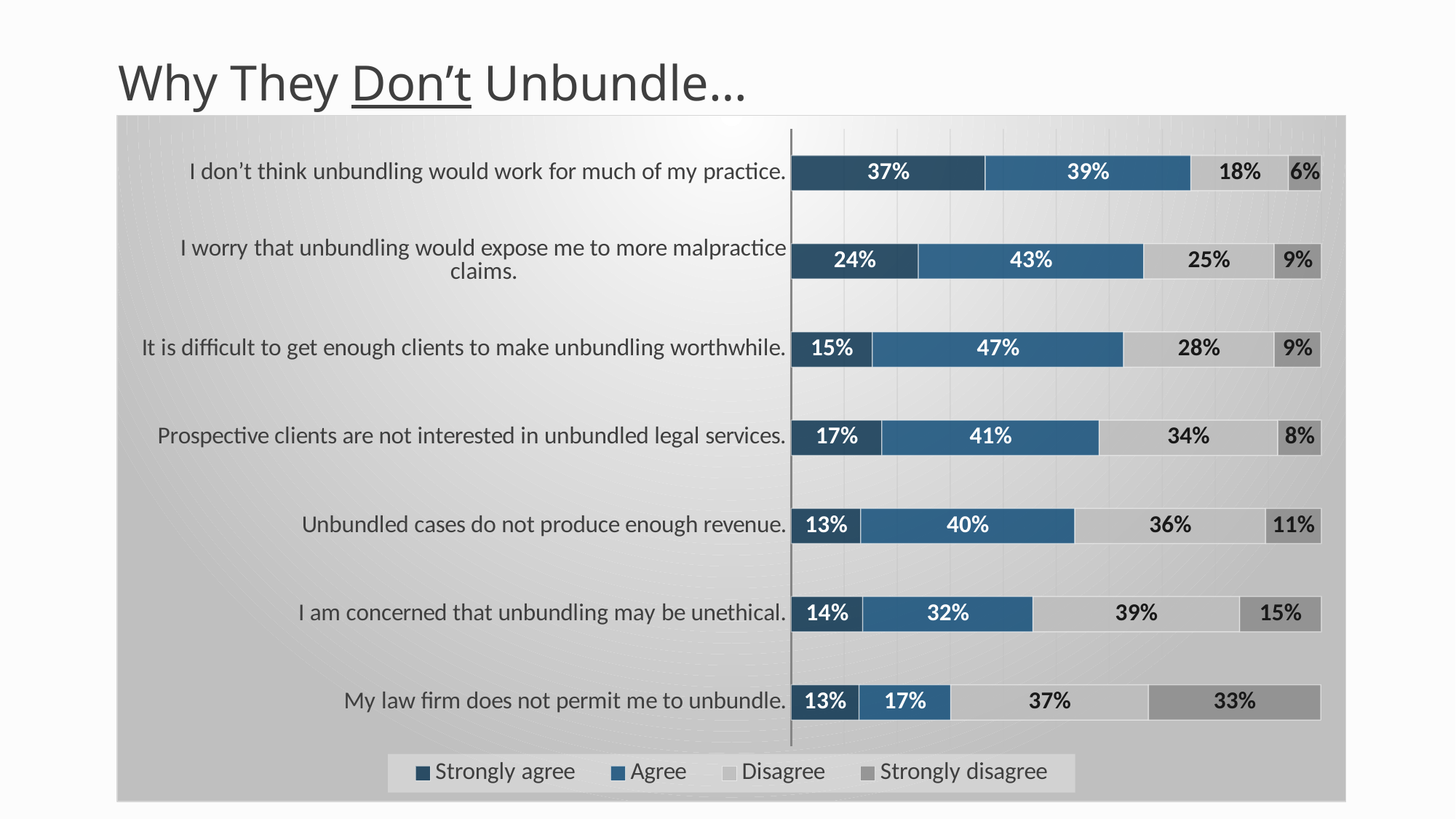
Which is larger: the Disagree percentage for "I am concerned that unbundling may be unethical" or the Disagree percentage for "Prospective clients are not interested in unbundled legal services"? I am concerned that unbundling may be unethical. What is the difference between the Agree and Strongly agree percentages for "I worry that unbundling would expose me to more malpractice claims"? 19% What kind of chart is shown on the slide? Stacked bar chart Which statement has the lowest Agree percentage? My law firm does not permit me to unbundle. How many series does the legend list? 4 What is the combined Strongly agree and Agree percentage for "I don't think unbundling would work for much of my practice"? 76% Which statement has the highest Strongly agree percentage? I don't think unbundling would work for much of my practice. What percentage strongly agree that "I don't think unbundling would work for much of my practice"? 37% What percentage disagree that "Unbundled cases do not produce enough revenue"? 36% What percentage agree that "It is difficult to get enough clients to make unbundling worthwhile"? 47% What percentage strongly disagree that "My law firm does not permit me to unbundle"? 33% How many statements are listed in the chart? 7